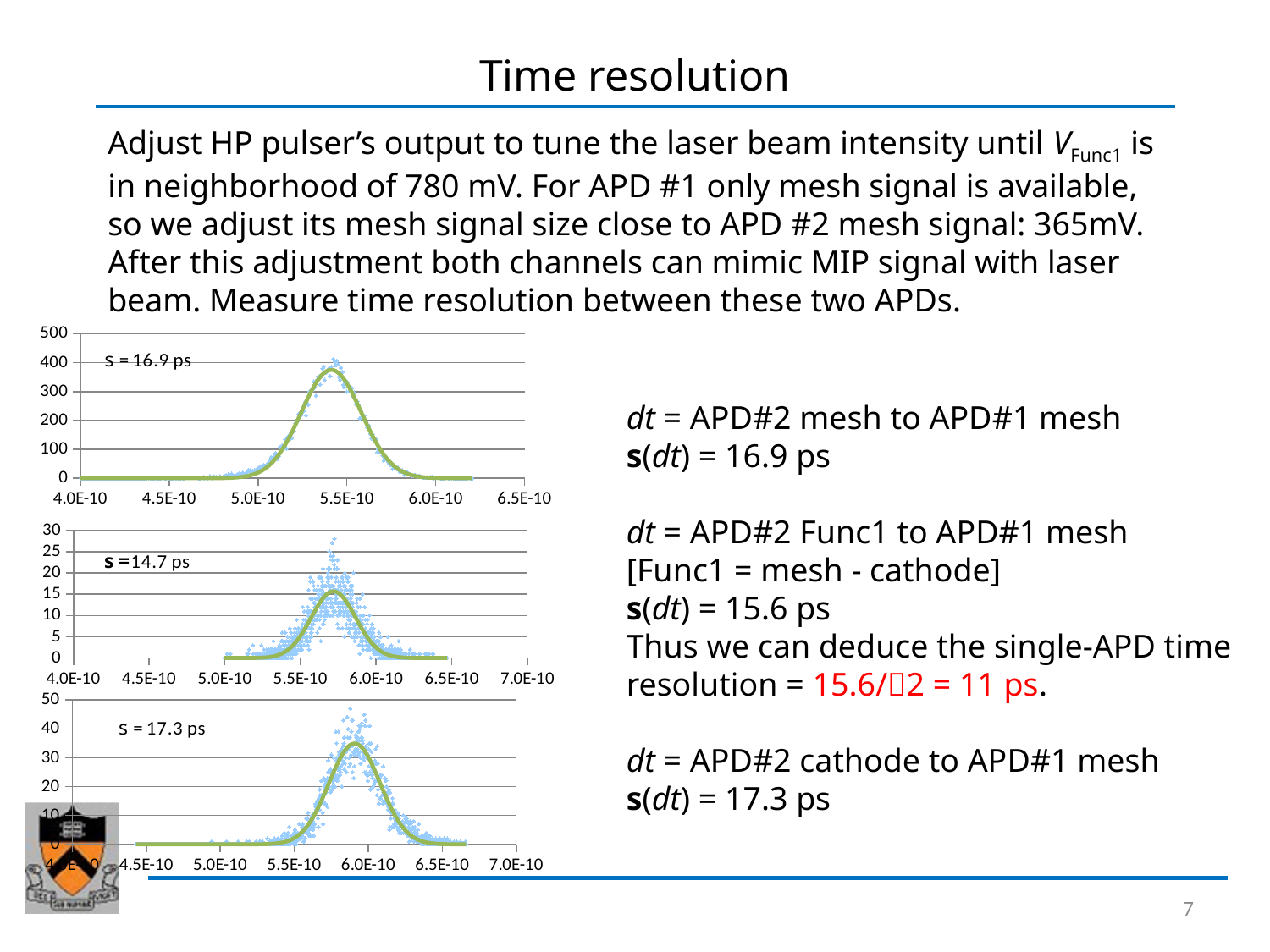
What is the maximum value shown on the y axis of the middle chart? 30 In the top chart, is the peak of the fitted curve greater or less than 300? greater Which of the three charts has the smallest printed s value? middle chart (14.7 ps) What is the difference between the s value printed on the bottom chart and the s value printed on the middle chart? 2.6 ps What kind of chart is the top chart on the slide? scatter chart What value of s is printed on the top chart? s = 16.9 ps Which of the three charts has the largest printed s value? bottom chart (17.3 ps) How many charts are shown on the slide? 3 What value of s is printed on the bottom chart? s = 17.3 ps What value of s is printed on the middle chart? s = 14.7 ps In the bottom chart, is the peak of the fitted curve greater or less than 20? greater